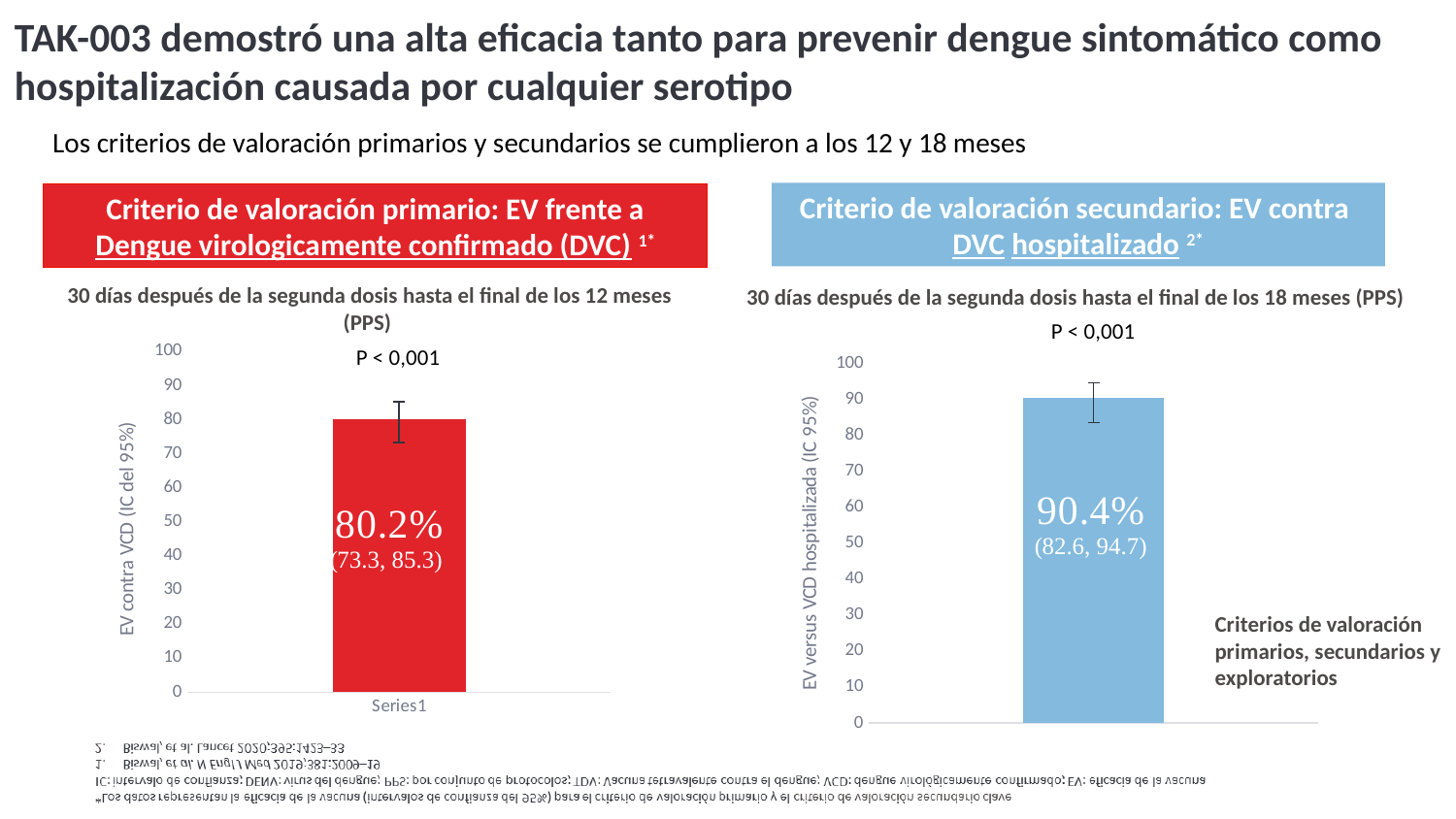
In the left chart (12 meses), is the bar value greater or less than 70? greater In the right chart (18 meses), what confidence interval is printed below the 90.4% label? (82.6, 94.7) In the right chart (18 meses), is the bar value greater or less than 100? less In the left chart (12 meses), what value is printed on the bar? 80.2% Which bar is taller: the 80.2% bar in the left chart or the 90.4% bar in the right chart? the 90.4% bar in the right chart What is the difference between the value in the right chart (90.4%) and the value in the left chart (80.2%)? 10.2 percentage points What is the y-axis label of the left chart (12 meses)? EV contra VCD (IC del 95%) In the right chart (18 meses), what value is printed on the bar? 90.4% What kind of chart is the left chart (12 meses)? bar chart How many bars are plotted in the right chart (18 meses)? 1 In the left chart (12 meses), what confidence interval is printed below the 80.2% label? (73.3, 85.3) What colour is the bar in the right chart (18 meses)? light blue